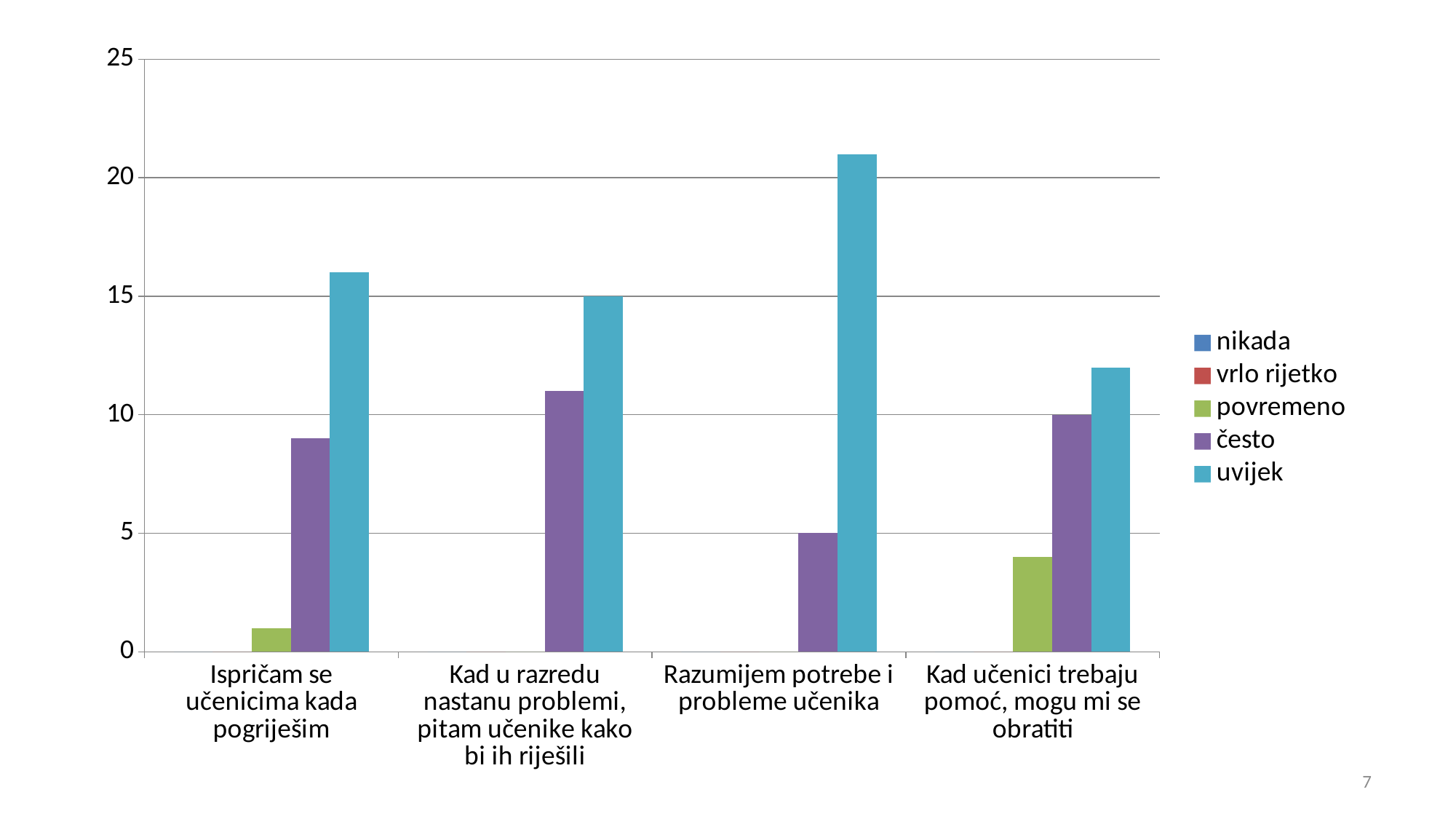
What is the value of 'često' for 'Razumijem potrebe i probleme učenika'? 5 Which category has the highest 'uvijek' value? Razumijem potrebe i probleme učenika Which category has the lowest 'uvijek' value? Kad učenici trebaju pomoć, mogu mi se obratiti How many series does the legend list? 5 What is the value of 'uvijek' for 'Kad u razredu nastanu problemi, pitam učenike kako bi ih riješili'? 15 Is the value of 'uvijek' for 'Razumijem potrebe i probleme učenika' greater or less than 20? greater What is the value of 'često' for 'Kad učenici trebaju pomoć, mogu mi se obratiti'? 10 Which legend entry is listed last? uvijek How many categories are shown on the x axis? 4 Is the value of 'često' for 'Ispričam se učenicima kada pogriješim' greater or less than 10? less What kind of chart is shown on the slide? bar chart Which is larger: 'često' for 'Kad u razredu nastanu problemi, pitam učenike kako bi ih riješili' or 'često' for 'Ispričam se učenicima kada pogriješim'? Kad u razredu nastanu problemi, pitam učenike kako bi ih riješili